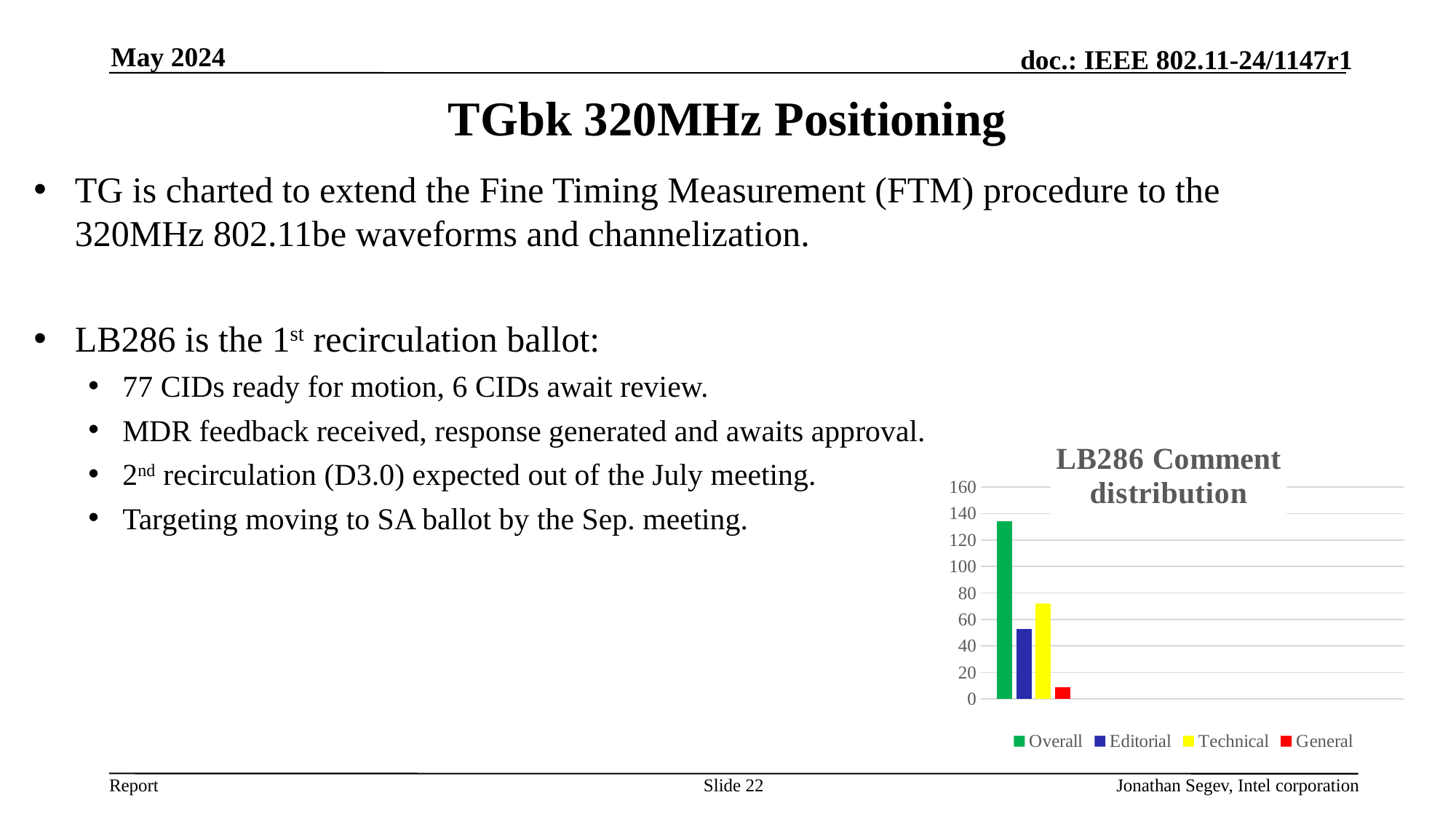
What colour is the Technical series in the LB286 Comment distribution chart? yellow In the LB286 Comment distribution chart, which is larger, Editorial or Technical? Technical What kind of chart is the LB286 Comment distribution chart? bar chart Which series has the lowest value in the LB286 Comment distribution chart? General How many series does the legend of the LB286 Comment distribution chart list? 4 What is the title of the chart on the slide? LB286 Comment distribution Is the value for Editorial in the LB286 Comment distribution chart greater or less than 60? less Is the value for Overall in the LB286 Comment distribution chart greater or less than 120? greater Which series has the highest value in the LB286 Comment distribution chart? Overall Is the value for Technical in the LB286 Comment distribution chart greater or less than 60? greater In the LB286 Comment distribution chart, which is larger, Overall or Technical? Overall